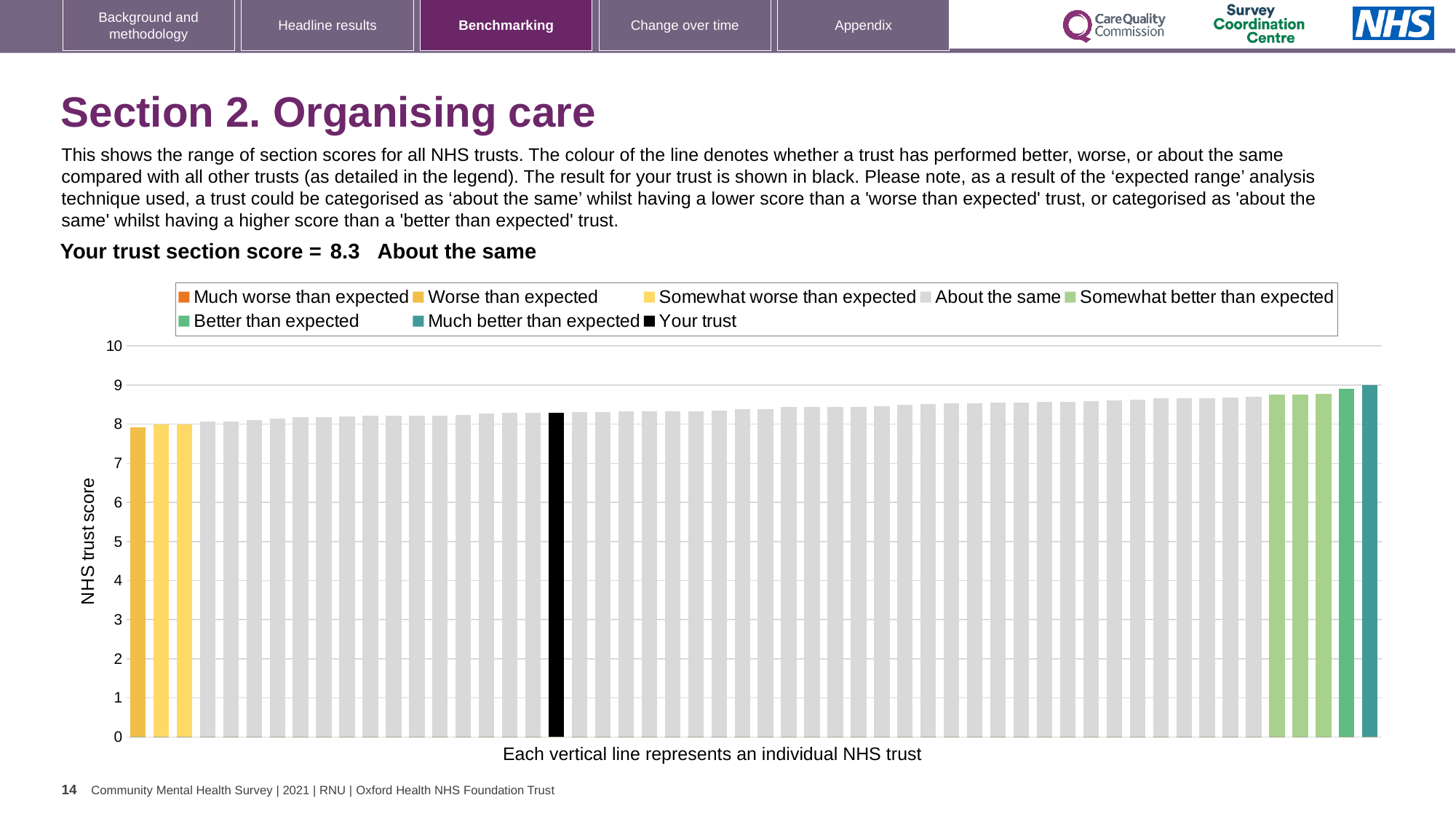
Is the tallest bar on the chart greater or less than 8? greater Is the value of the black bar (your trust) greater or less than 9? less What is the label on the vertical axis of the chart? NHS trust score How many entries does the chart legend list? 8 What colour is used for the bar representing your trust? Black What is the section score for your trust shown on the slide? 8.3 Which legend category does the tallest bar on the chart belong to? Much better than expected What kind of chart is shown on the slide? Bar chart Do the bar values rise or fall from left to right along the x axis? rise Which category is your trust placed in for this section? About the same Is the value of the black bar (your trust) greater or less than 8? greater